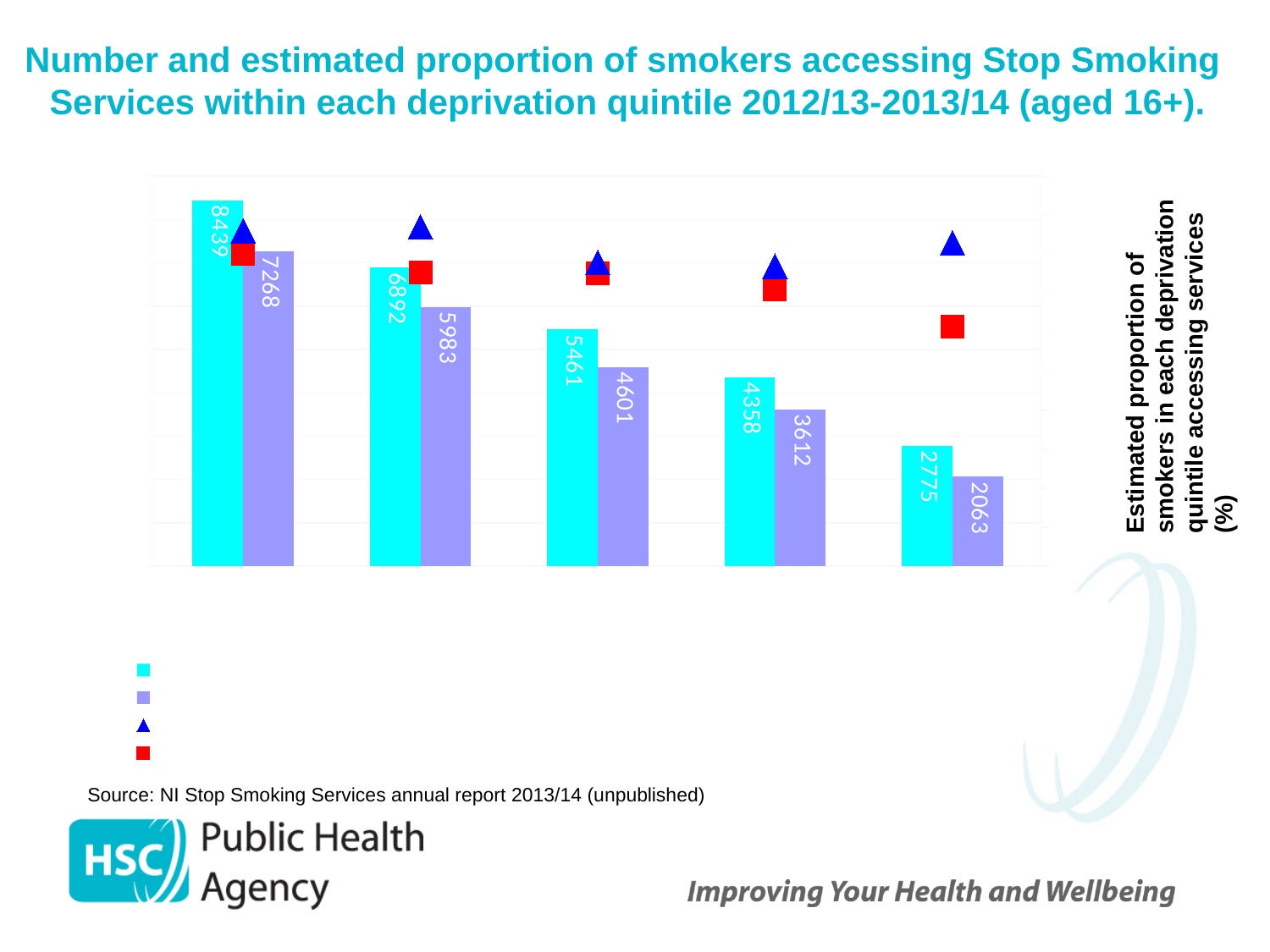
What kind of chart is shown on the slide? Bar chart What is the value printed on the cyan bar in the fourth group from the left? 4358 Which bar has the highest value in the chart? The cyan bar in the leftmost group (8439) How many entries does the legend list? 4 What is the value printed on the purple bar in the middle (third) group? 4601 What is the value printed on the cyan bar in the leftmost group? 8439 How many groups of bars are plotted in the chart? 5 Do the cyan bar values rise or fall from left to right across the chart? Fall In the second group from the left, which bar is larger, the cyan bar or the purple bar? The cyan bar (6892) What is the value printed on the purple bar in the rightmost group? 2063 What is the difference between the cyan and purple bars in the leftmost group? 1171 Which bar has the lowest value in the chart? The purple bar in the rightmost group (2063)